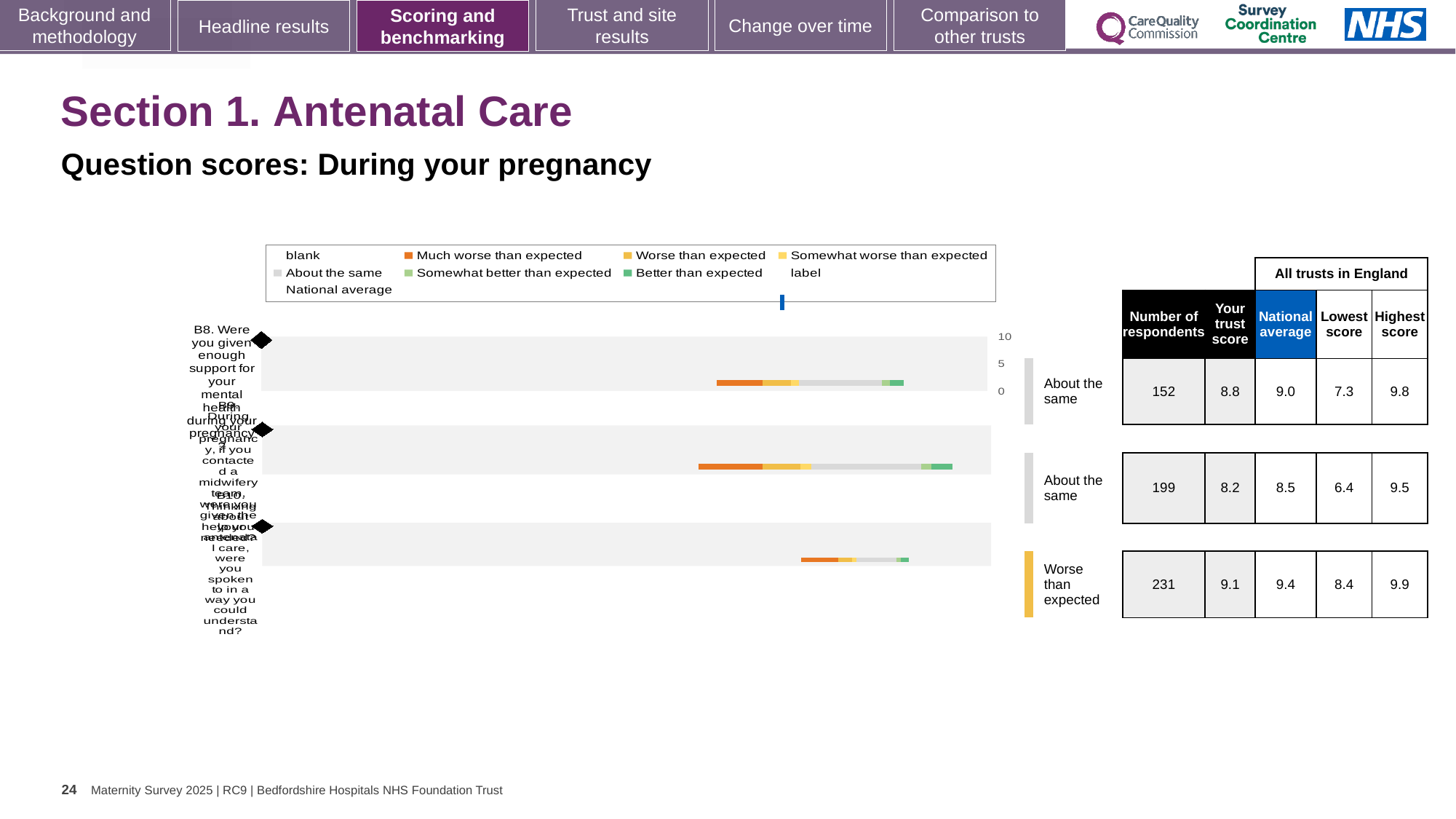
In the table, what is the difference between the national average and the trust score for the first row (B8)? 0.2 In the table, which row has the larger trust score, the second row (8.2) or the third row (9.1)? The third row (9.1) In the table, which row has the highest number of respondents? The third row (231) What kind of chart is shown on the slide? Bar chart In the table, what is the national average for the first row (B8)? 9.0 In the table, what is the trust score for the first row (B8)? 8.8 How many question rows are plotted in the chart? 3 In the table, what is the number of respondents for the first row (B8, support for your mental health during pregnancy)? 152 In the table, what is the lowest score for the first row (B8)? 7.3 What benchmark category label is shown next to the third row of the chart? Worse than expected In the table, which row has the lowest 'Lowest score' value? The second row (6.4) In the table, what is the highest score for the third row? 9.9